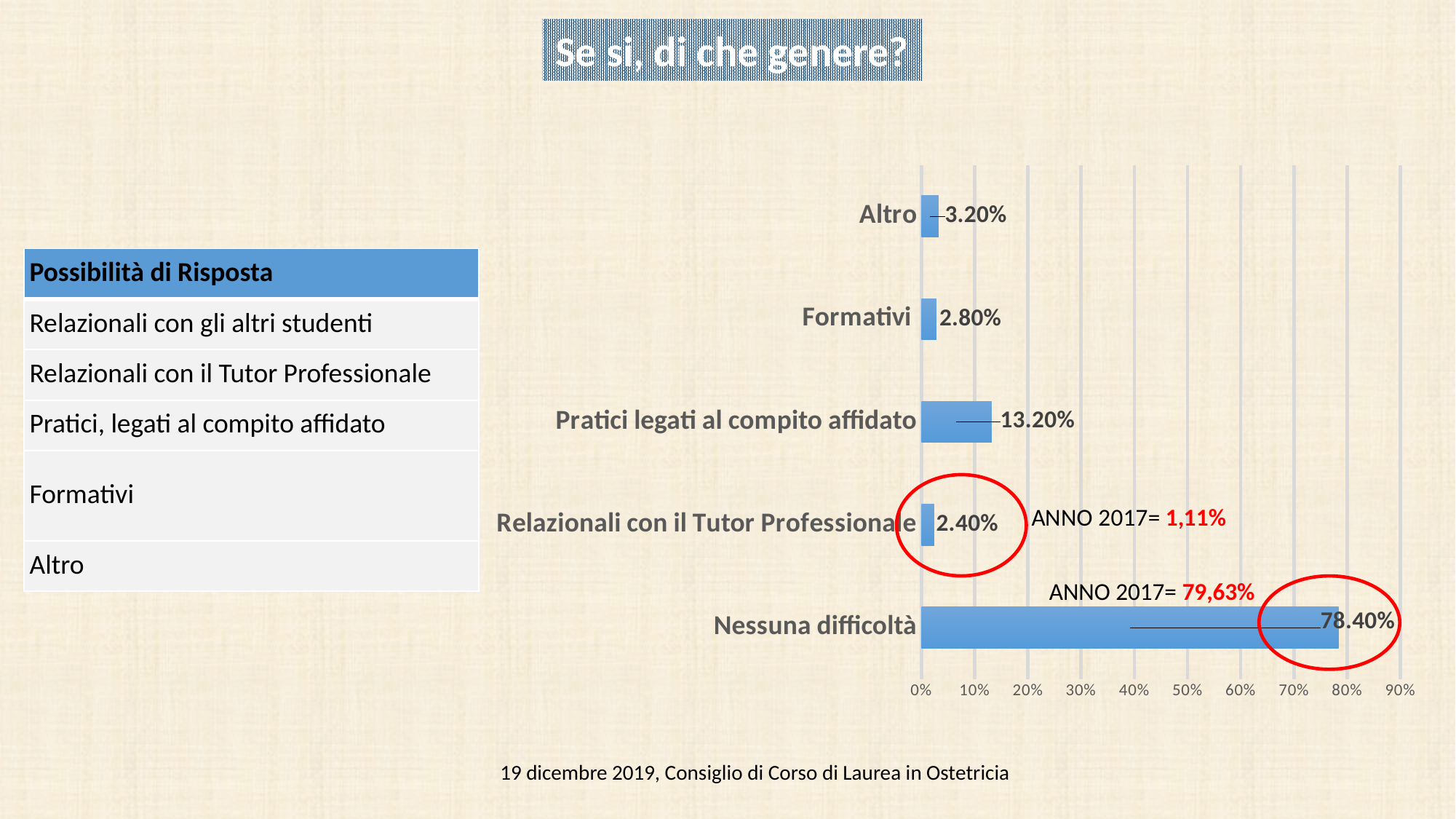
What is the value for Nessuna difficoltà? 78.40% Which is larger, the value for Altro or the value for Formativi? Altro How many categories are shown in the chart? 5 Which category has the highest value? Nessuna difficoltà Which category has the lowest value? Relazionali con il Tutor Professionale Is the value for Nessuna difficoltà greater or less than 70%? greater What is the value for Relazionali con il Tutor Professionale? 2.40% What is the value for Pratici legati al compito affidato? 13.20% What is the value for Formativi? 2.80% What is the value for Altro? 3.20% What is the difference between the values for Nessuna difficoltà and Pratici legati al compito affidato? 65.20% What kind of chart is shown on the slide? bar chart